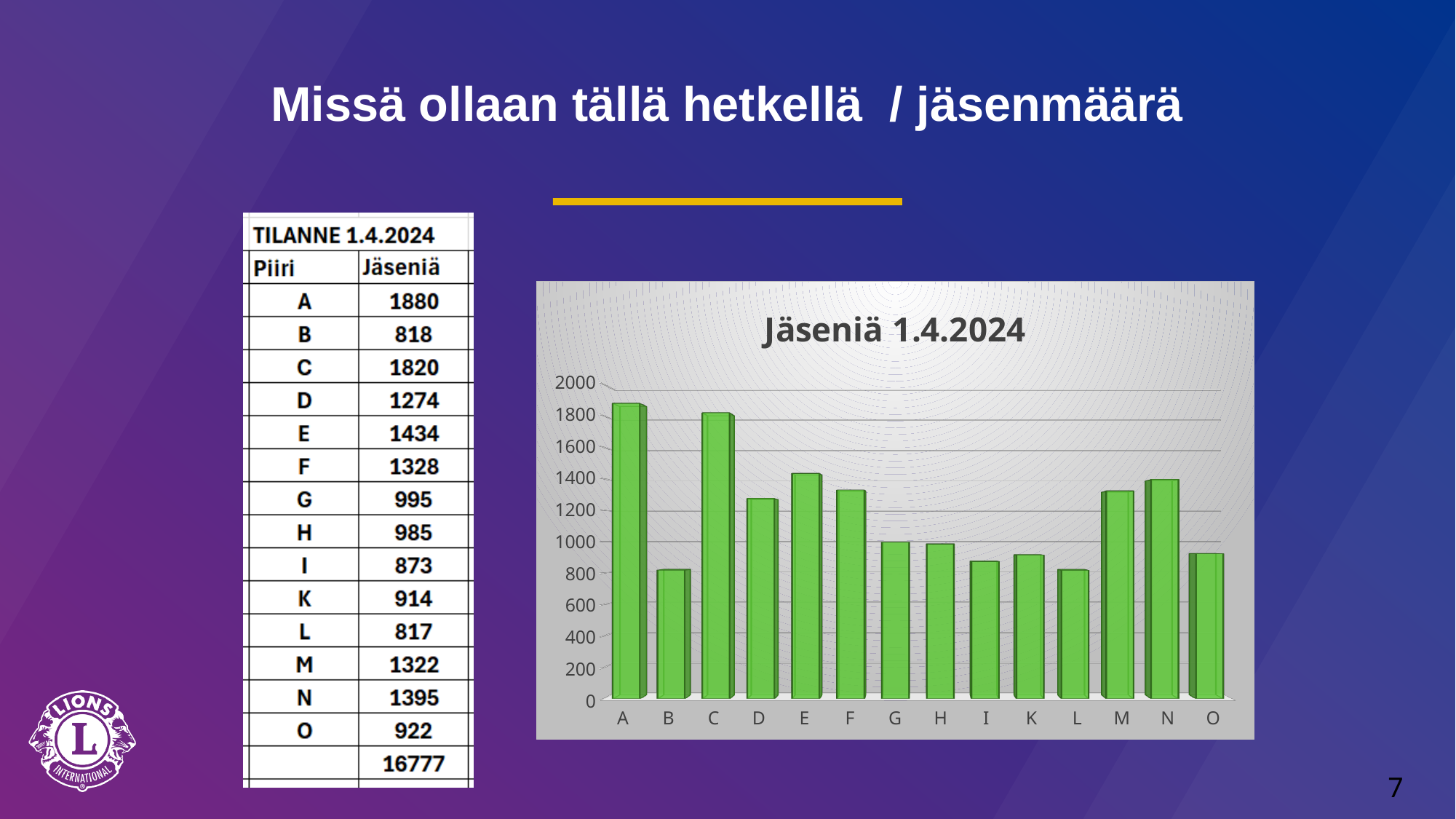
Is the value for I greater or less than 1000? less What is the value for category I? 873 Is the value for N greater or less than 1200? greater What kind of chart is shown on the slide? bar chart Which category has the highest value in the chart? A How many categories (piiri) are shown on the x axis of the chart? 14 What is the value for category A? 1880 What is the difference between the values for A and C? 60 Which is larger, the value for E or the value for D? E What is the difference between the values for N and M? 73 What is the title of the chart? Jäseniä 1.4.2024 What is the value for category N? 1395